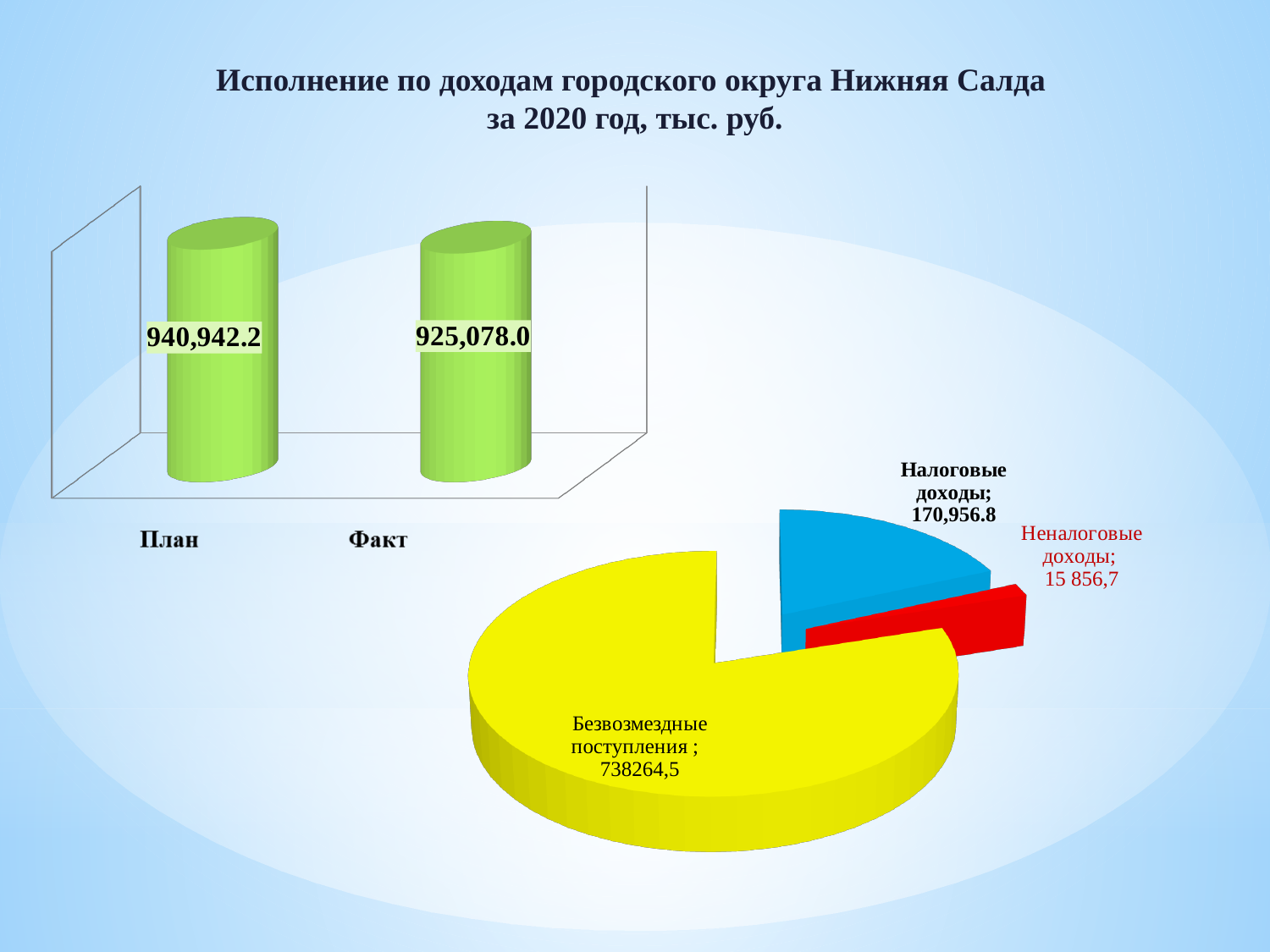
On the pie chart, how many slices are there? 3 What kind of chart is shown on the left of the slide? Bar chart On the pie chart, which slice is the largest? Безвозмездные поступления On the bar chart on the left, how many categories are shown? 2 On the bar chart on the left, what is the value for Факт? 925,078.0 On the pie chart, what is the value for Неналоговые доходы? 15 856,7 What kind of chart is shown on the right of the slide? Pie chart On the bar chart on the left, which category has the higher value, План or Факт? План On the pie chart, which slice is the smallest? Неналоговые доходы On the bar chart on the left, what is the difference between the План and Факт values? 15,864.2 On the bar chart on the left, what is the value for План? 940,942.2 On the pie chart, what is the value for Налоговые доходы? 170,956.8